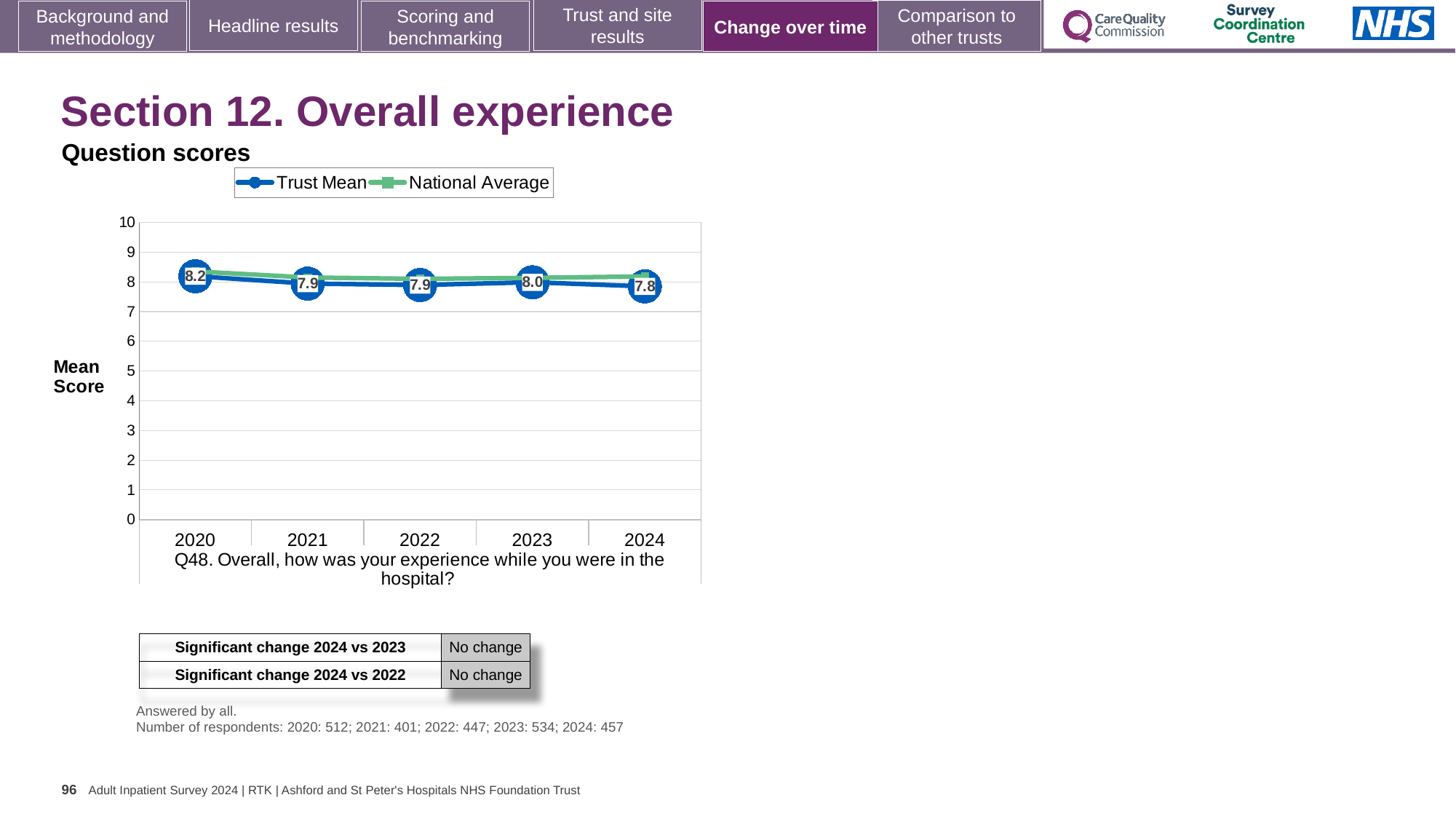
What is the Trust Mean score for 2023? 8.0 Does the Trust Mean score rise or fall from 2020 to 2024? fall What is the difference between the Trust Mean scores for 2020 and 2024? 0.4 How many series does the legend list? 2 Is the Trust Mean score for 2024 greater or less than 7? greater How many years are plotted on the x axis? 5 What kind of chart is shown on the slide? line chart What is the Trust Mean score for 2024? 7.8 What is the Trust Mean score for 2020? 8.2 Which year has the larger Trust Mean score, 2023 or 2024? 2023 In which year is the Trust Mean score lowest? 2024 In which year is the Trust Mean score highest? 2020